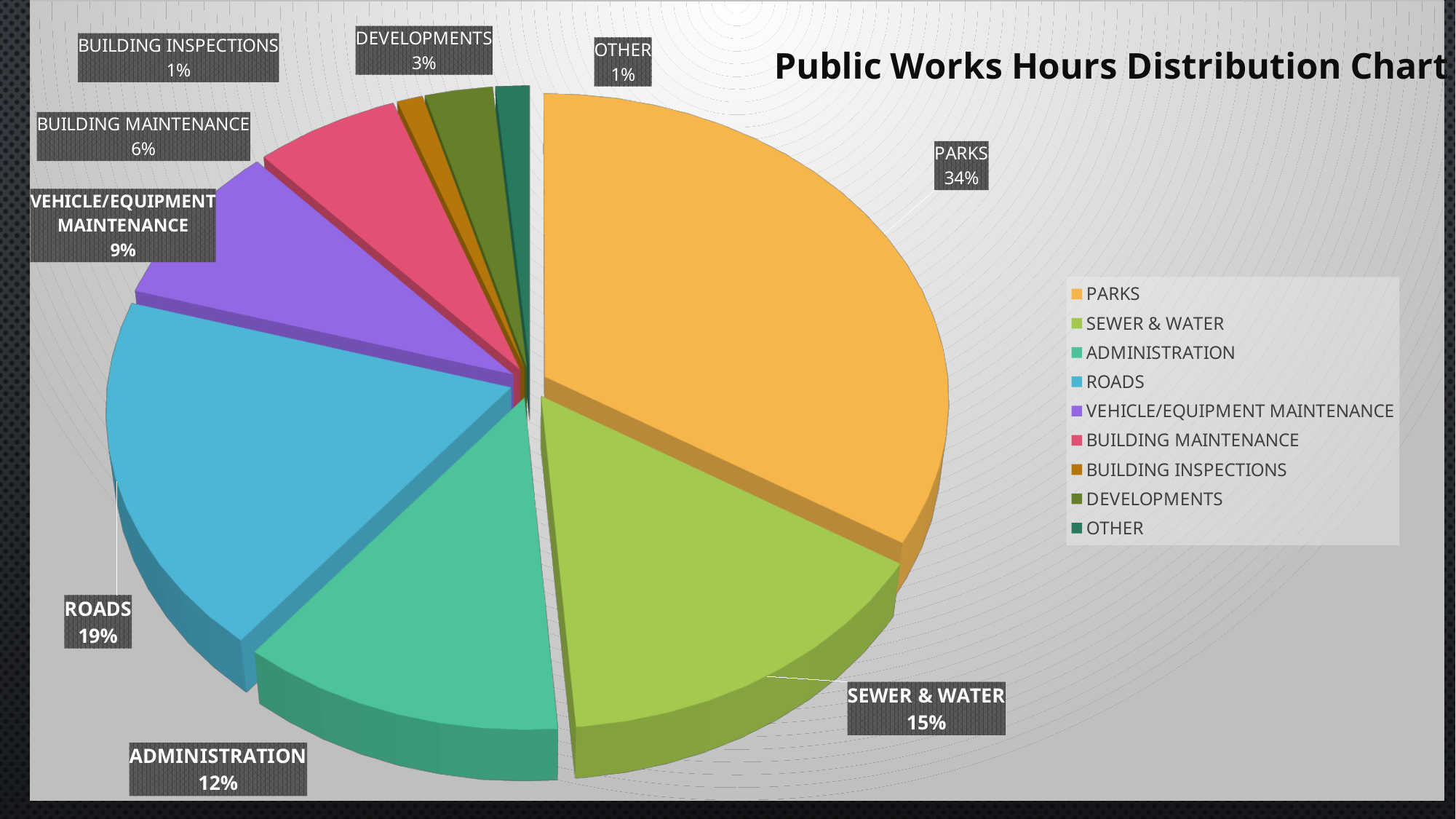
What percentage of hours is attributed to ROADS? 19% What colour represents ROADS in the chart? Blue Which has a larger share, ADMINISTRATION or BUILDING MAINTENANCE? ADMINISTRATION How many categories does the legend list? 9 What is the combined share of BUILDING INSPECTIONS and DEVELOPMENTS? 4% What percentage of hours is attributed to VEHICLE/EQUIPMENT MAINTENANCE? 9% What type of chart is shown on the slide? Pie chart What is the difference in percentage points between PARKS and SEWER & WATER? 19 What percentage of hours is attributed to PARKS? 34% What percentage of hours is attributed to DEVELOPMENTS? 3% What is the title of the chart? Public Works Hours Distribution Chart Which category has the largest share of hours? PARKS